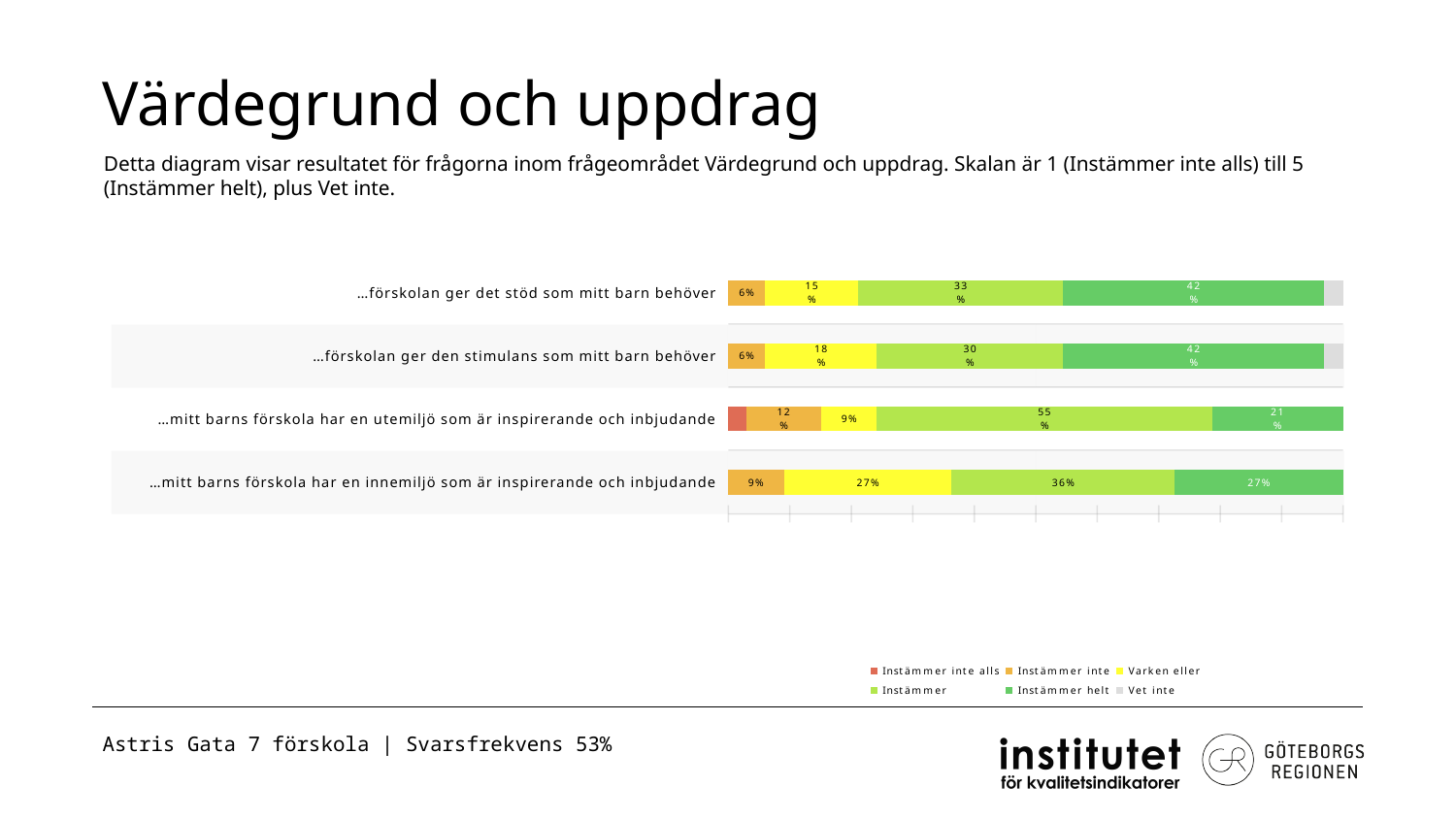
What is the 'Instämmer' share for '…mitt barns förskola har en utemiljö som är inspirerande och inbjudande'? 55% Which is larger: the 'Instämmer inte' share for '…mitt barns förskola har en innemiljö som är inspirerande och inbjudande' or for '…mitt barns förskola har en utemiljö som är inspirerande och inbjudande'? …mitt barns förskola har en utemiljö som är inspirerande och inbjudande What is the difference between the 'Instämmer' share for '…förskolan ger det stöd som mitt barn behöver' (33%) and for '…förskolan ger den stimulans som mitt barn behöver' (30%)? 3% What kind of chart is shown on the slide? stacked bar chart Which statement has the largest 'Instämmer' (light green) segment? …mitt barns förskola har en utemiljö som är inspirerande och inbjudande What is the 'Instämmer inte' share for '…förskolan ger den stimulans som mitt barn behöver'? 6% Which statement has the smallest 'Instämmer helt' segment? …mitt barns förskola har en utemiljö som är inspirerande och inbjudande What is the 'Varken eller' share for '…mitt barns förskola har en innemiljö som är inspirerande och inbjudande'? 27% How many series does the legend list? 6 What is the 'Instämmer helt' share for '…förskolan ger det stöd som mitt barn behöver'? 42% How many statements (categories) are plotted in the chart? 4 Which legend entry is shown in yellow? Varken eller